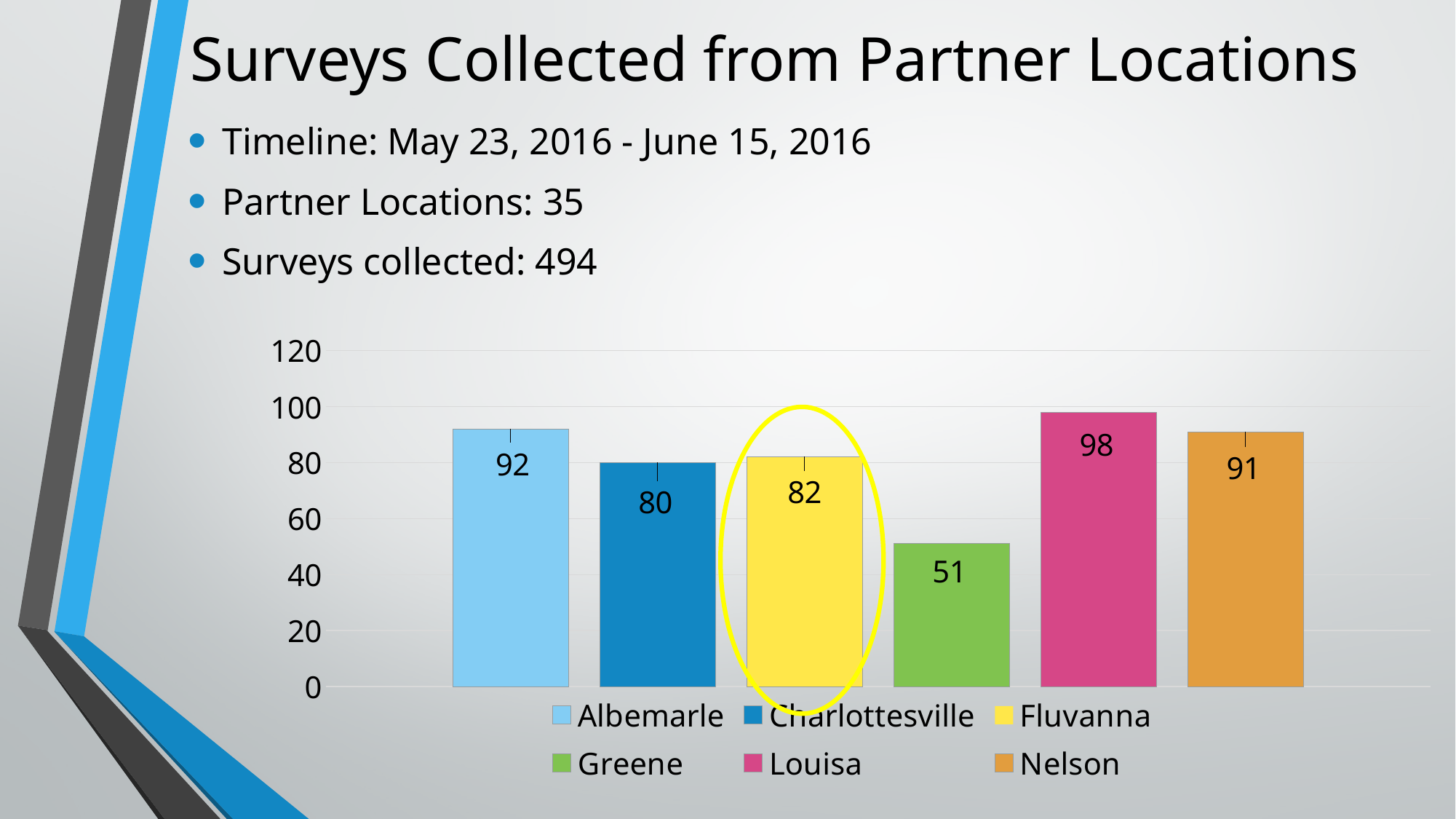
Is the value for Greene greater or less than 60? less What kind of chart is shown on the slide? bar chart What is the value for Charlottesville? 80 Which category has the highest value? Louisa What is the value for Albemarle? 92 How many categories are shown in the chart? 6 What is the value for Greene? 51 How many entries does the legend list? 6 Which bar is circled in yellow on the chart? Fluvanna Which is larger, the value for Fluvanna or the value for Nelson? Nelson What is the difference between the values for Louisa and Greene? 47 Which category has the lowest value? Greene